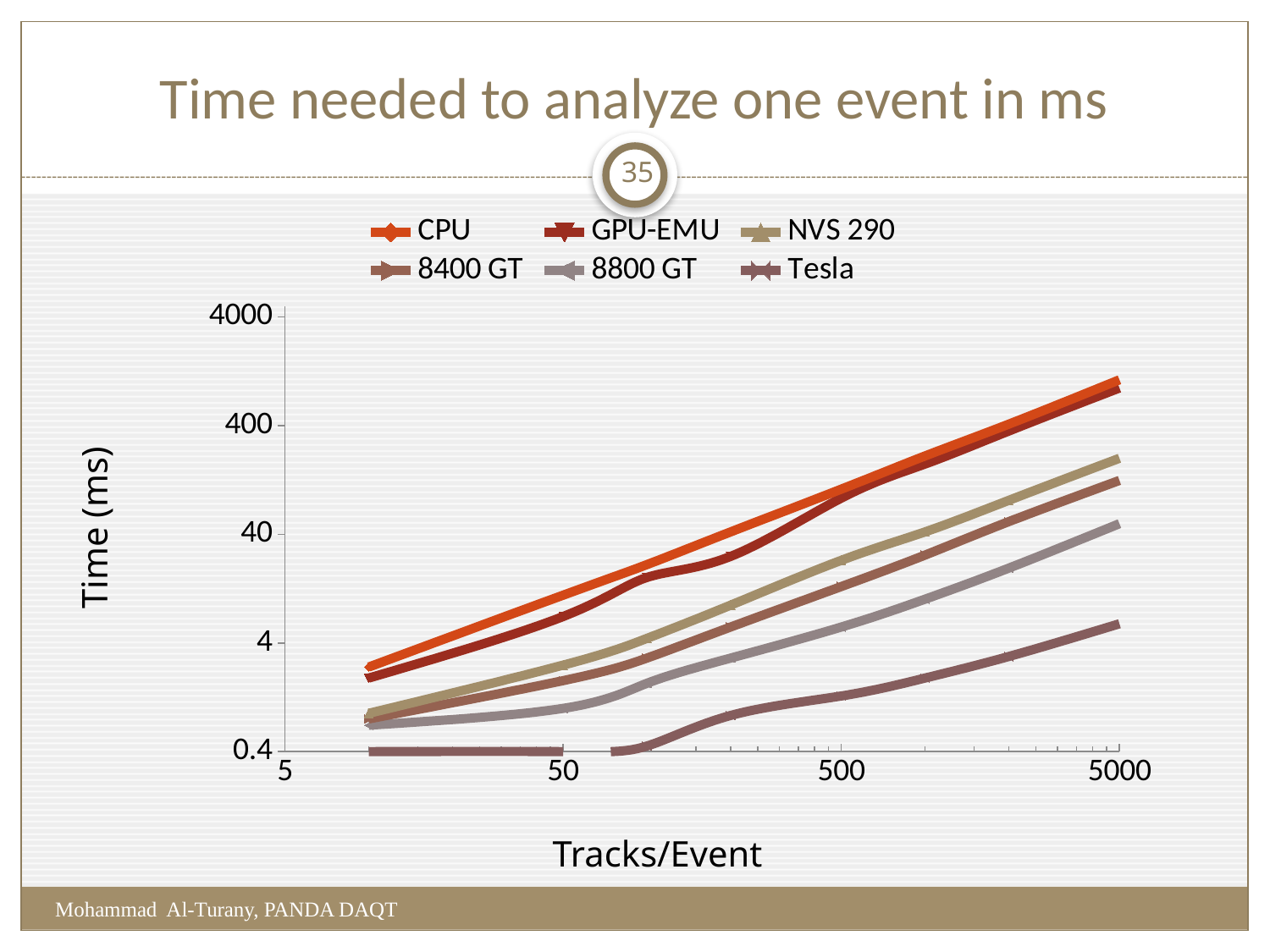
Which series has the highest time at 5000 tracks/event? CPU Is the time for Tesla at 50 tracks/event greater or less than 4 ms? less What is the label of the y axis? Time (ms) Is the time for NVS 290 at 5000 tracks/event greater or less than 40 ms? greater Which series has the lowest time at 5000 tracks/event? Tesla At 5000 tracks/event, which has the larger time: 8800 GT or Tesla? 8800 GT Is the time for CPU at 5000 tracks/event greater or less than 400 ms? greater What kind of chart is shown on the slide? line chart Does the time for CPU rise or fall as tracks/event increases? rises What is the label of the x axis? Tracks/Event How many series does the legend list? 6